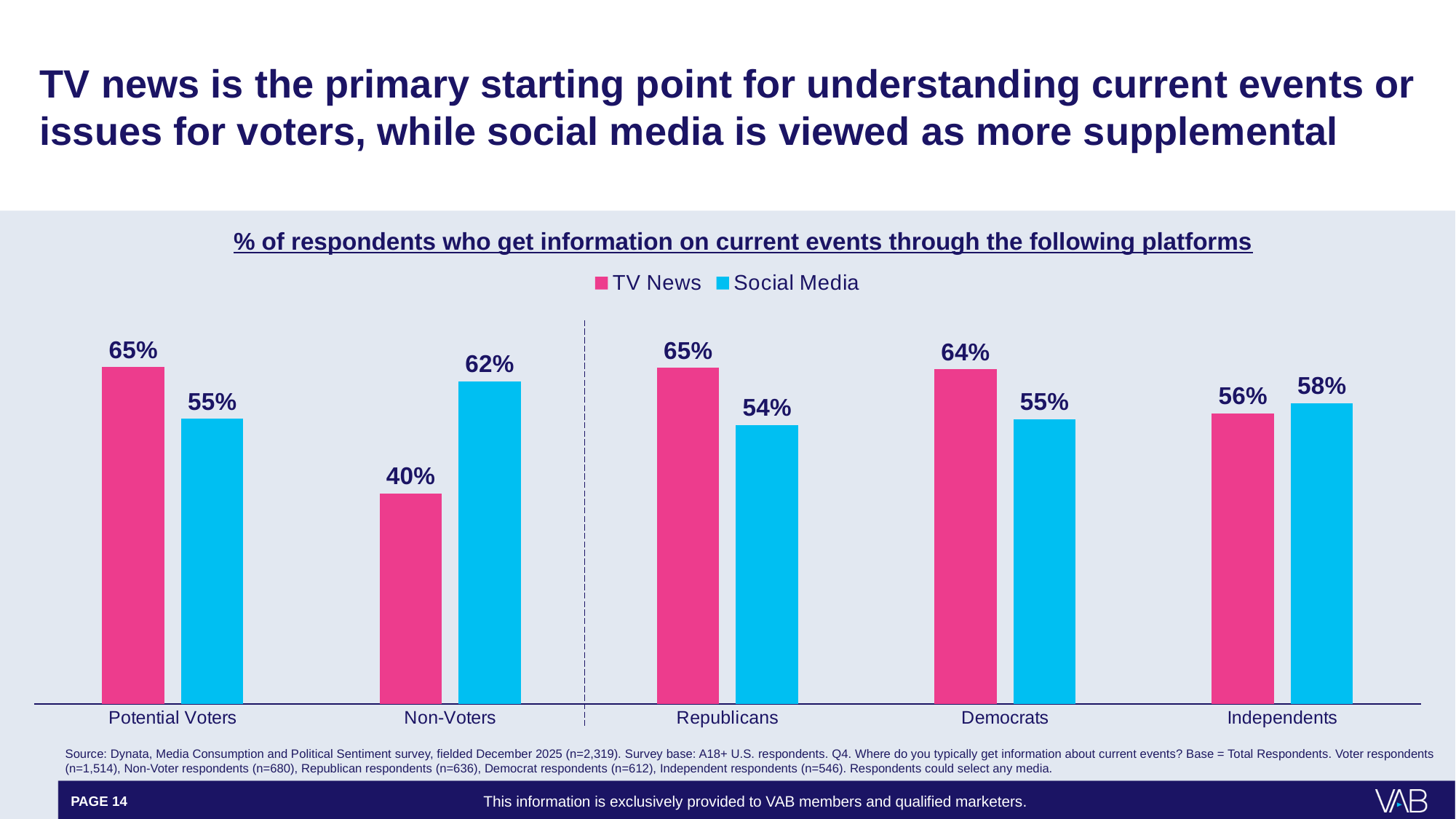
What kind of chart is shown on the slide? Bar chart What percentage of Non-Voters get information on current events through Social Media? 62% How many categories are shown on the x axis? 5 Which colour represents Social Media in the chart? Blue For Democrats, which is larger: the TV News value or the Social Media value? TV News What is the difference between the TV News and Social Media values for Non-Voters? 22% What is the TV News value for Independents? 56% What is the Social Media value for Republicans? 54% Which category has the lowest TV News value? Non-Voters What percentage of Potential Voters get information on current events through TV News? 65% How many series does the legend list? 2 Which category has the highest Social Media value? Non-Voters